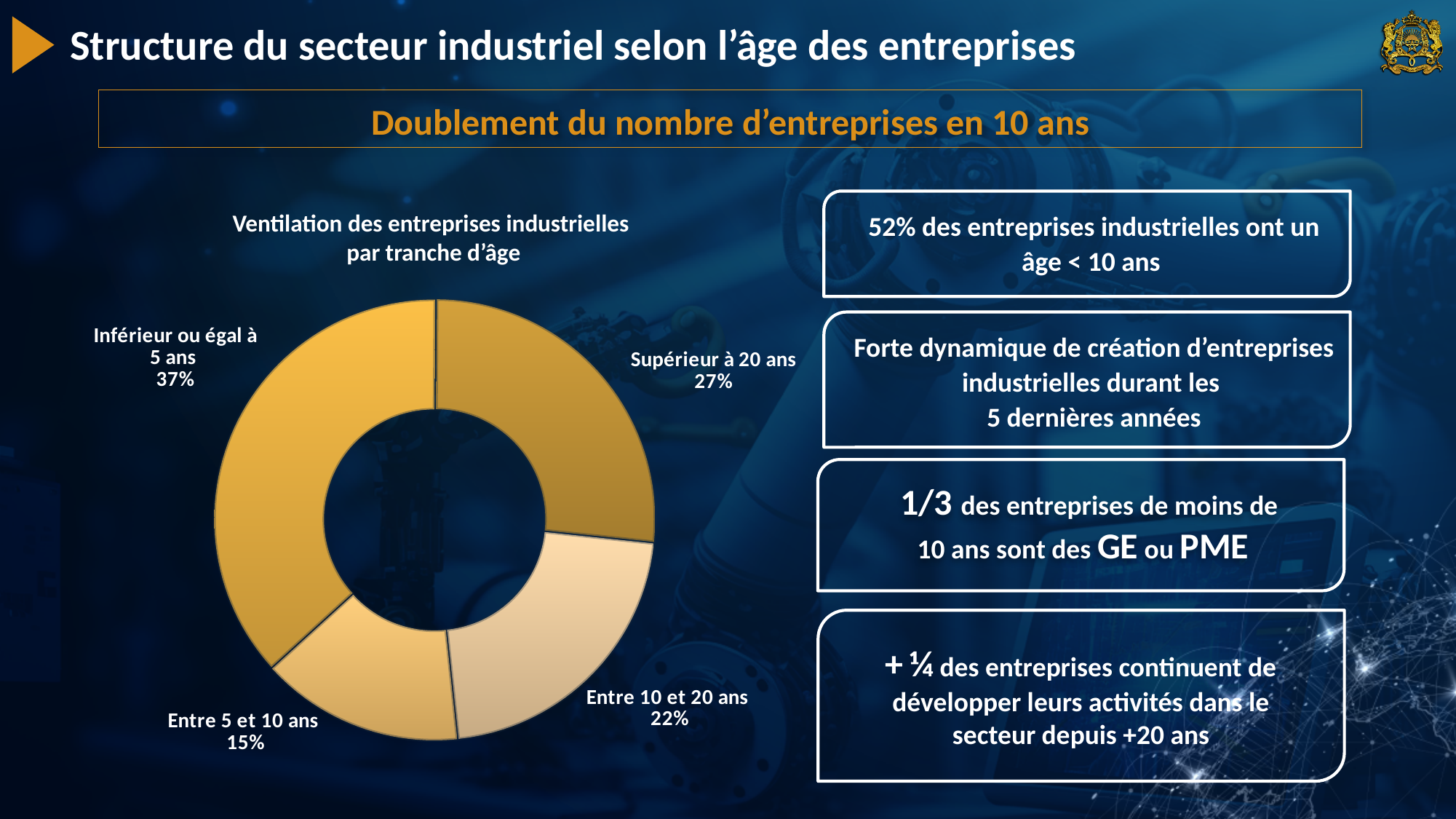
What kind of chart is used to show the breakdown of industrial enterprises by age? Doughnut (pie) chart Which age category has the largest share of industrial enterprises? Inférieur ou égal à 5 ans What is the combined share of enterprises aged 10 years or less ('Inférieur ou égal à 5 ans' plus 'Entre 5 et 10 ans')? 52% What is the title of the chart? Ventilation des entreprises industrielles par tranche d'âge What share of industrial enterprises are in the 'Entre 5 et 10 ans' category? 15% Which age category has the smallest share of industrial enterprises? Entre 5 et 10 ans What share of industrial enterprises are in the 'Supérieur à 20 ans' category? 27% What share of industrial enterprises are in the 'Inférieur ou égal à 5 ans' category? 37% How many age categories are shown in the chart? 4 What is the difference in percentage points between the 'Inférieur ou égal à 5 ans' and 'Supérieur à 20 ans' shares? 10 Which is larger: the share for 'Entre 10 et 20 ans' or the share for 'Entre 5 et 10 ans'? Entre 10 et 20 ans What share of industrial enterprises are in the 'Entre 10 et 20 ans' category? 22%